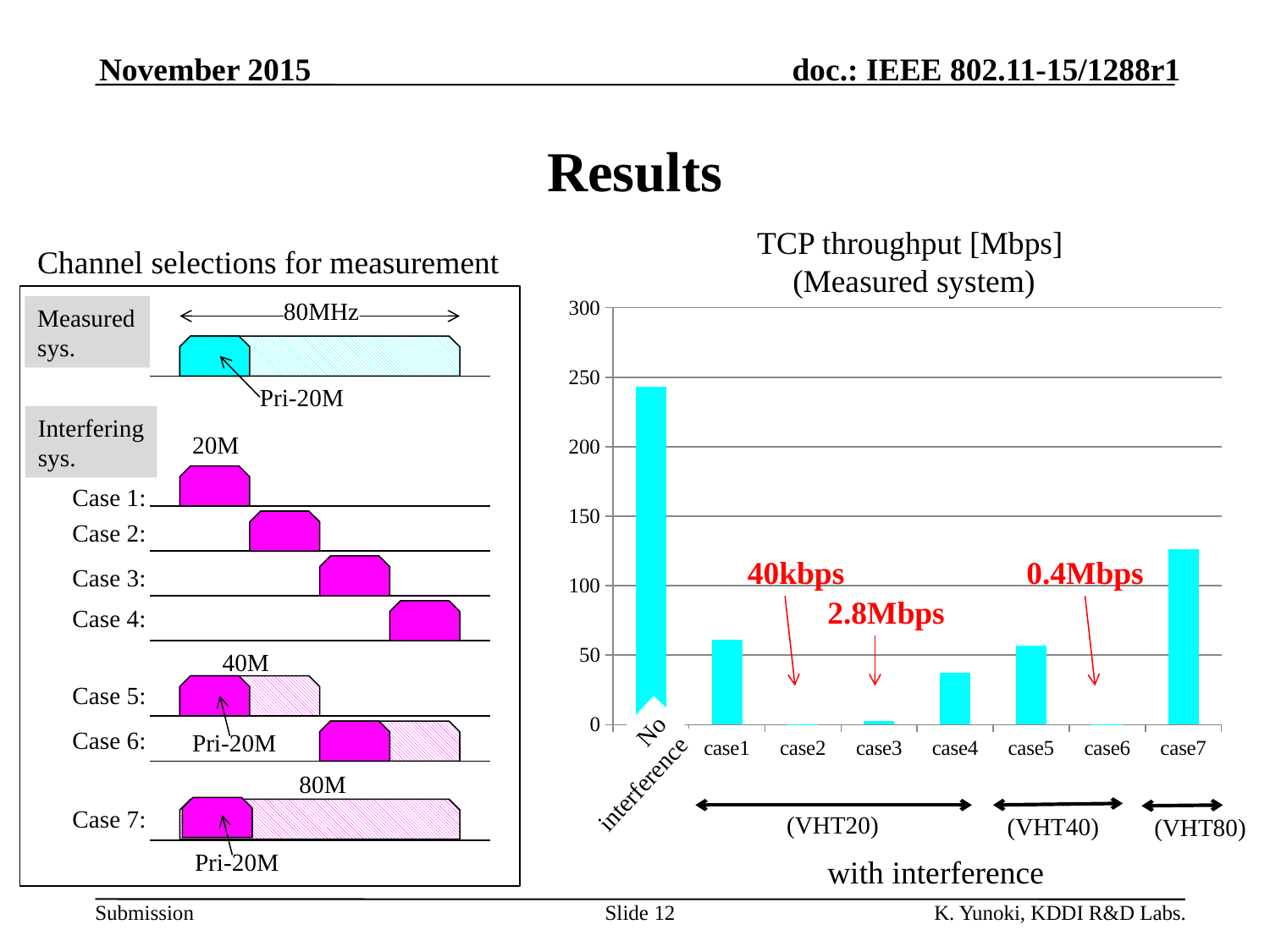
Is the TCP throughput for No interference greater or less than 200? greater Is the TCP throughput for case7 greater or less than 100? greater Is the TCP throughput for case4 greater or less than 50? less What is the TCP throughput labelled for case3? 2.8Mbps What is the title of the chart? TCP throughput [Mbps] (Measured system) What kind of chart is shown on the slide? bar chart Which category has the highest TCP throughput? No interference Which has the higher TCP throughput, case1 or case4? case1 What is the TCP throughput labelled for case2? 40kbps Which category has the lowest TCP throughput? case2 How many categories are plotted along the x axis of the chart? 8 What is the TCP throughput labelled for case6? 0.4Mbps